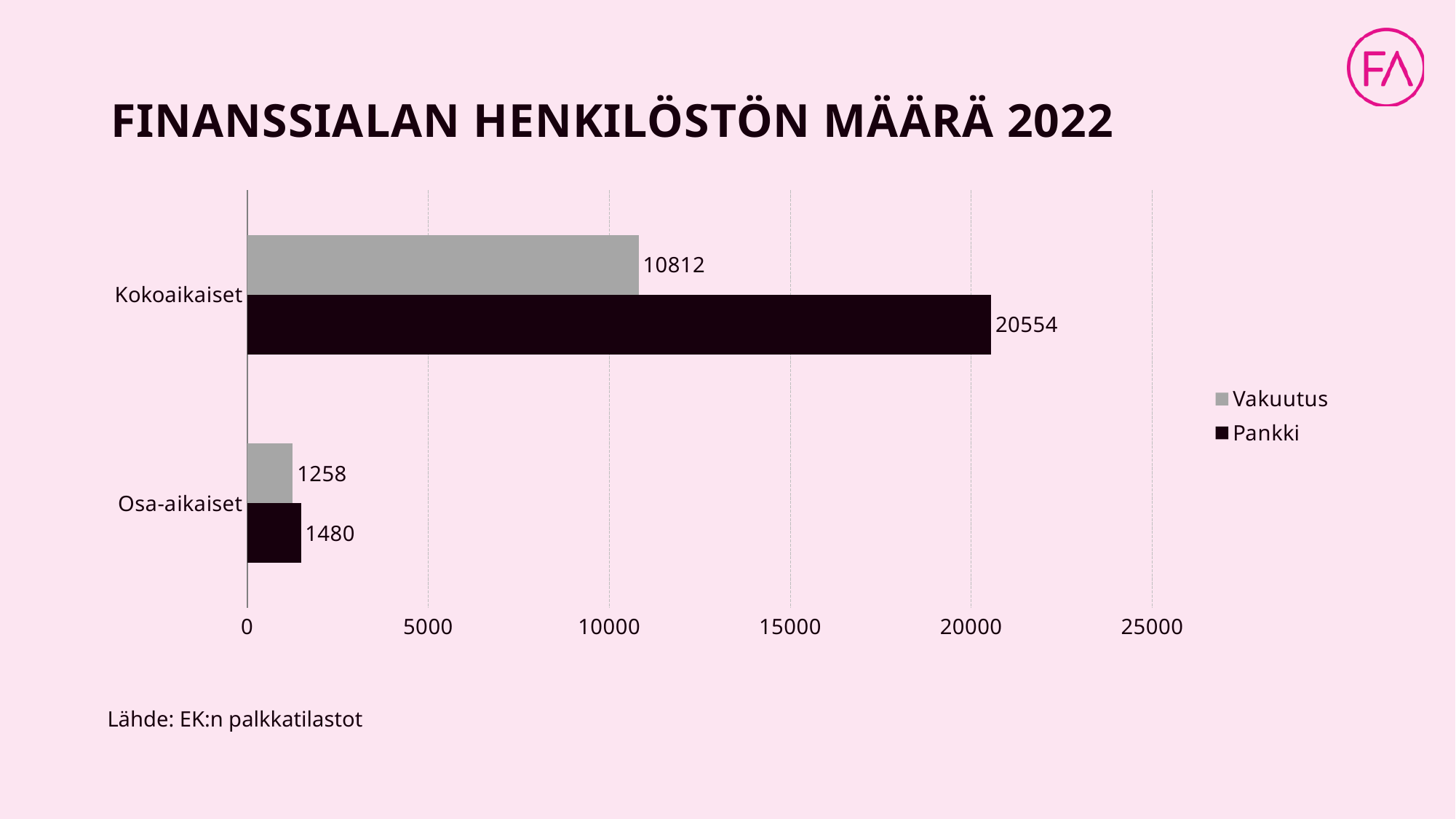
What is the difference between the Pankki and Vakuutus values for Kokoaikaiset? 9742 Which bar has the highest value on the chart? Pankki, Kokoaikaiset How many series does the legend list? 2 Which is larger for Kokoaikaiset, Vakuutus or Pankki? Pankki Which bar has the lowest value on the chart? Vakuutus, Osa-aikaiset What is the value for Vakuutus in the Kokoaikaiset category? 10812 What is the difference between the Pankki and Vakuutus values for Osa-aikaiset? 222 What is the value for Pankki in the Osa-aikaiset category? 1480 What is the value for Pankki in the Kokoaikaiset category? 20554 What is the value for Vakuutus in the Osa-aikaiset category? 1258 What kind of chart is shown on the slide? Bar chart Is the value for Pankki in Kokoaikaiset greater or less than 20000? greater